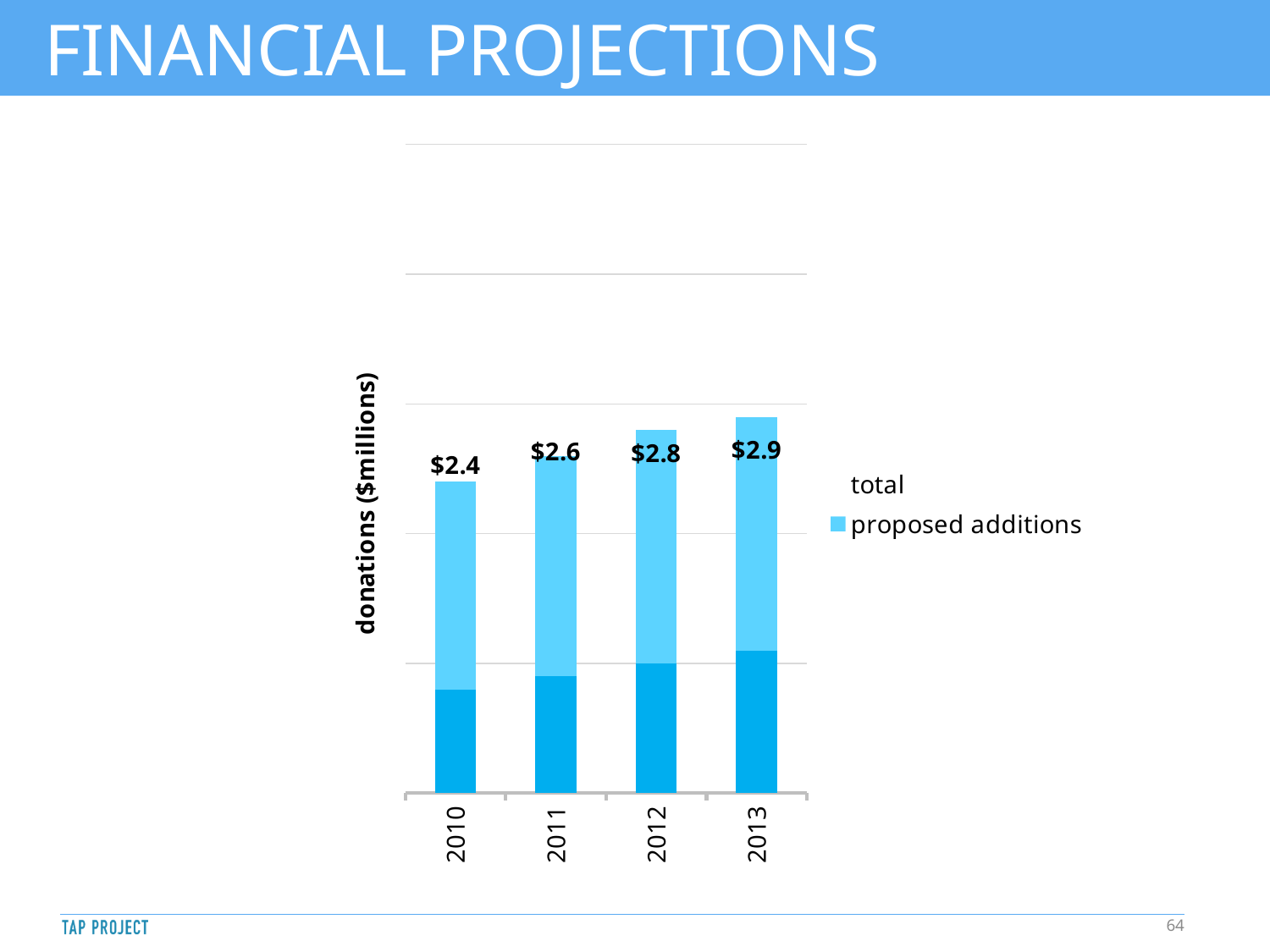
Which year has the highest labelled value? 2013 How many series does the legend list? 2 What value is labelled on the bar for 2010? $2.4 What value is labelled on the bar for 2011? $2.6 What is the label on the vertical axis? donations ($millions) Which year has the larger labelled value, 2011 or 2012? 2012 What value is labelled on the bar for 2013? $2.9 What is the difference between the labelled values for 2013 and 2010? $0.5 Which year has the lowest labelled value? 2010 Do the labelled values rise or fall from 2010 to 2013? Rise What kind of chart is shown on the slide? Stacked bar chart How many years are shown on the x axis? 4